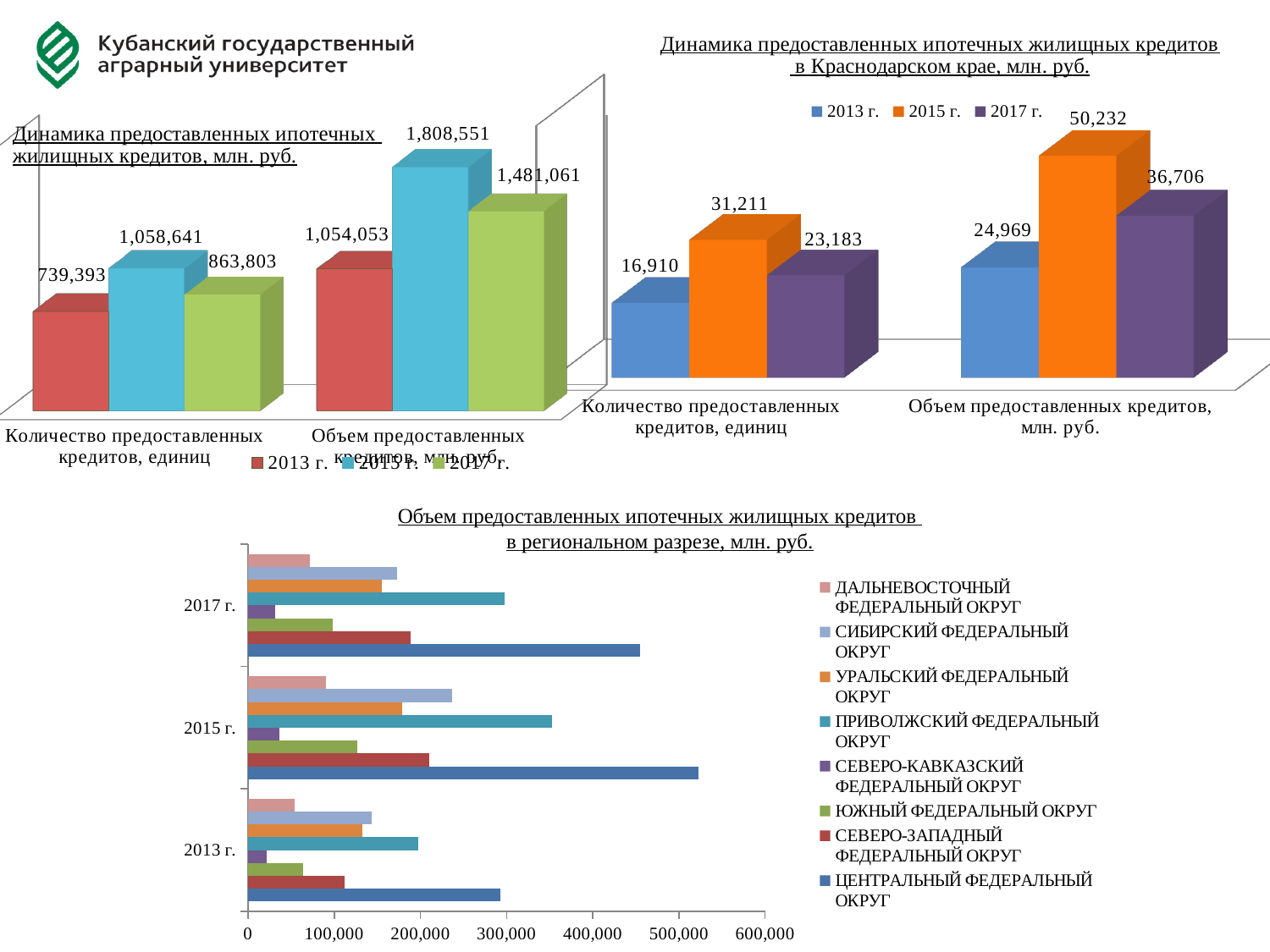
In the top-right chart 'Динамика предоставленных ипотечных жилищных кредитов в Краснодарском крае, млн. руб.', what is the value for 2017 г. in the category 'Количество предоставленных кредитов, единиц'? 23,183 In the top-left chart 'Динамика предоставленных ипотечных жилищных кредитов, млн. руб.', what is the value for 2013 г. in the category 'Количество предоставленных кредитов, единиц'? 739,393 In the top-left chart 'Динамика предоставленных ипотечных жилищных кредитов, млн. руб.', what is the difference between the 2015 г. and 2017 г. values in the category 'Объем предоставленных кредитов, млн. руб.'? 327,490 In the top-right chart 'Динамика предоставленных ипотечных жилищных кредитов в Краснодарском крае, млн. руб.', how many series does the legend list? 3 What kind of chart is the bottom chart 'Объем предоставленных ипотечных жилищных кредитов в региональном разрезе, млн. руб.'? bar chart In the bottom chart 'Объем предоставленных ипотечных жилищных кредитов в региональном разрезе, млн. руб.', is the value for ЦЕНТРАЛЬНЫЙ ФЕДЕРАЛЬНЫЙ ОКРУГ in 2015 г. greater or less than 500,000? greater In the top-right chart 'Динамика предоставленных ипотечных жилищных кредитов в Краснодарском крае, млн. руб.', which year has the lowest value in the category 'Объем предоставленных кредитов, млн. руб.'? 2013 г. In the top-right chart 'Динамика предоставленных ипотечных жилищных кредитов в Краснодарском крае, млн. руб.', what is the value for 2015 г. in the category 'Объем предоставленных кредитов, млн. руб.'? 50,232 In the top-right chart 'Динамика предоставленных ипотечных жилищных кредитов в Краснодарском крае, млн. руб.', what is the difference between the 2015 г. and 2013 г. values in the category 'Количество предоставленных кредитов, единиц'? 14,301 In the top-left chart 'Динамика предоставленных ипотечных жилищных кредитов, млн. руб.', what is the value for 2015 г. in the category 'Объем предоставленных кредитов, млн. руб.'? 1,808,551 In the top-left chart 'Динамика предоставленных ипотечных жилищных кредитов, млн. руб.', which year has the highest value in the category 'Количество предоставленных кредитов, единиц'? 2015 г. In the bottom chart 'Объем предоставленных ипотечных жилищных кредитов в региональном разрезе, млн. руб.', which region has the highest value in 2017 г.? ЦЕНТРАЛЬНЫЙ ФЕДЕРАЛЬНЫЙ ОКРУГ